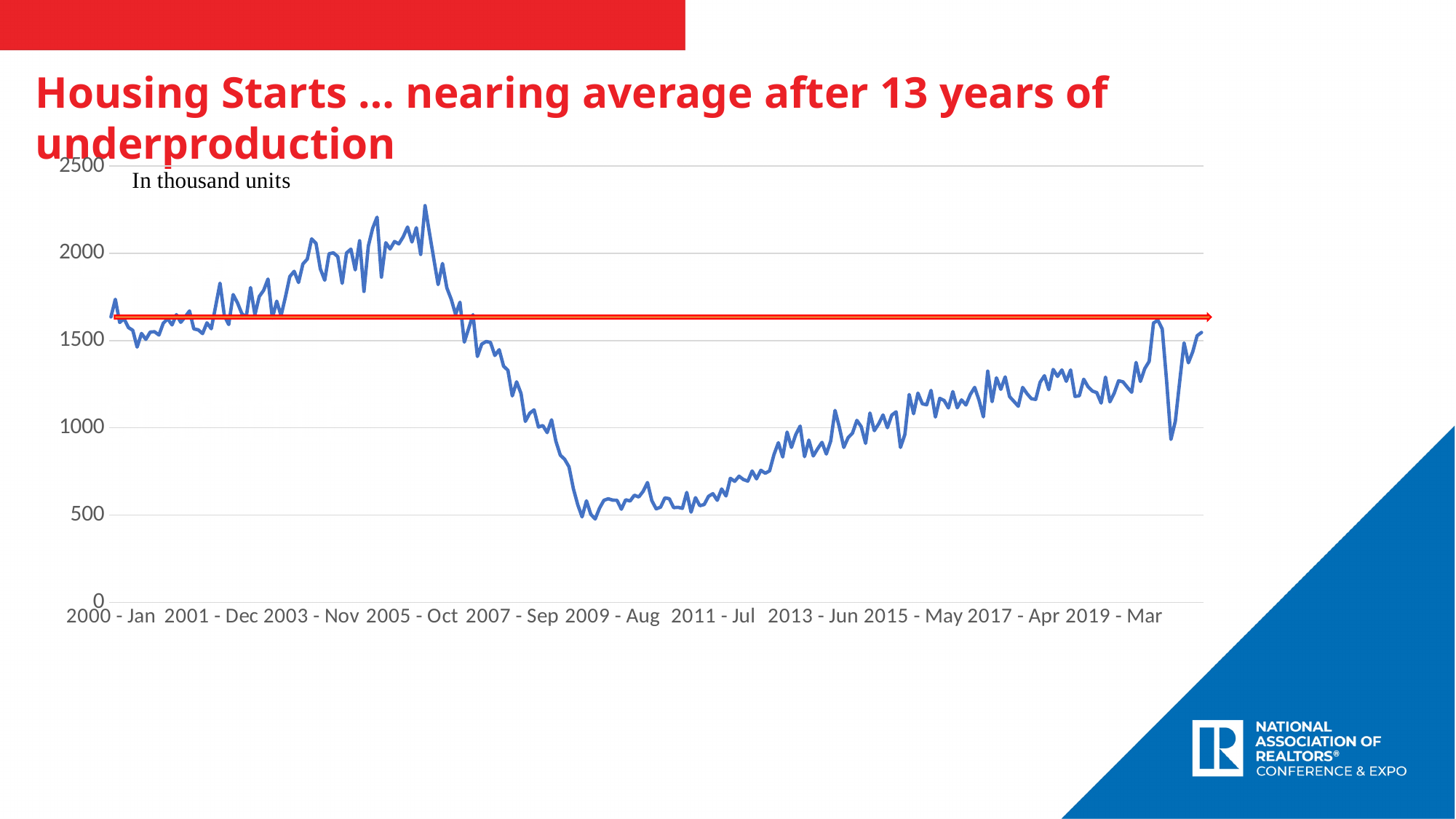
What is the title of the slide's chart? Housing Starts … nearing average after 13 years of underproduction Is the value for 2000 - Jan greater or less than 1000? greater In what units are the housing starts values plotted, according to the note on the chart? In thousand units Is the value for 2017 - Apr greater or less than 1500? less What kind of chart is shown on the slide? line chart Do the values rise or fall between 2011 - Jul and 2019 - Mar? rise Do the values rise or fall between 2007 - Sep and 2009 - Aug? fall Is the highest point on the line greater or less than 2000? greater How many date labels are shown on the x axis? 11 Which is larger, the value for 2005 - Oct or the value for 2009 - Aug? 2005 - Oct